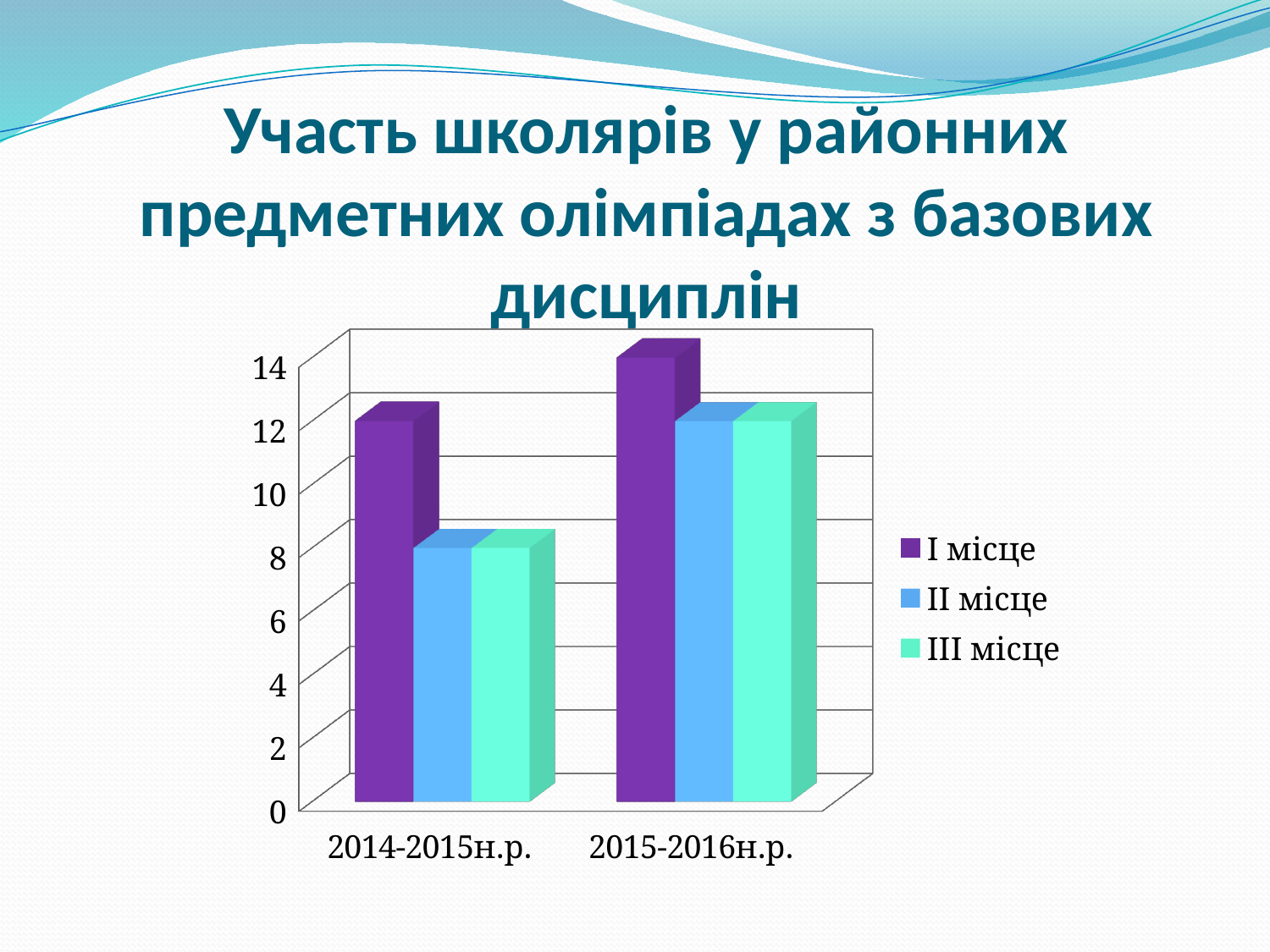
Which colour represents III місце in the legend? light green (turquoise) What is the value for II місце in 2014-2015н.р.? 8 What kind of chart is shown on the slide? bar chart Is the value for II місце in 2014-2015н.р. greater or less than 10? less How many school-year categories are shown on the x axis? 2 Which series has the highest value in 2015-2016н.р.? I місце Which is larger: I місце in 2014-2015н.р. or I місце in 2015-2016н.р.? 2015-2016н.р. What is the value for I місце in 2014-2015н.р.? 12 Is the value for I місце in 2015-2016н.р. greater or less than 12? greater How many series does the legend list? 3 What is the value for III місце in 2015-2016н.р.? 12 What is the value for I місце in 2015-2016н.р.? 14